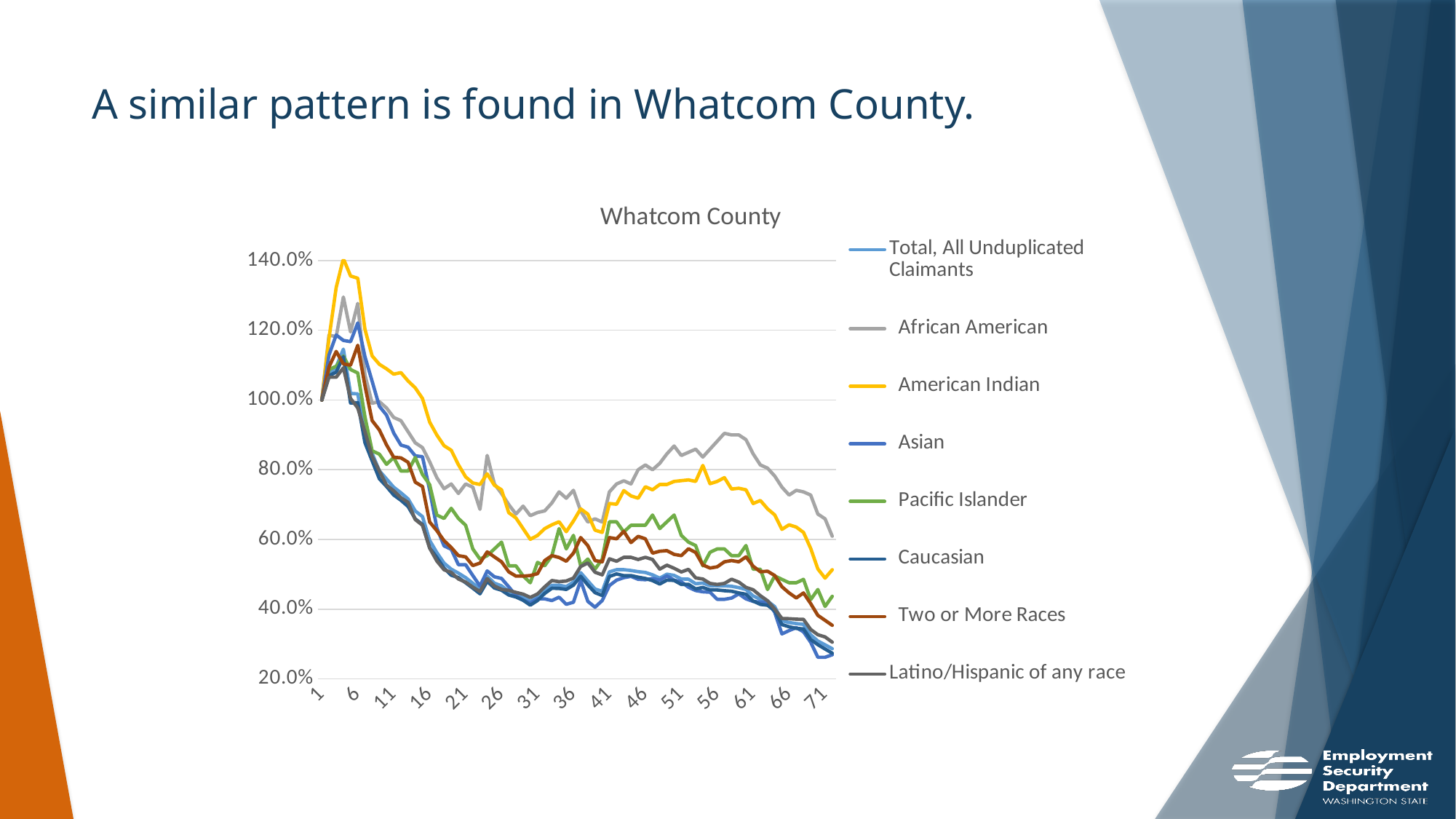
Overall, do the series rise or fall from the left of the x axis to the right? fall What kind of chart is shown on the slide? line chart Which series has the highest value at the right end of the chart (around point 71)? African American Is the value of the Total, All Unduplicated Claimants series at point 71 greater or less than 40.0%? less Which series reaches the highest peak on the chart? American Indian Is the value of the African American series at point 56 greater or less than 80.0%? greater How many series does the legend of the Whatcom County chart list? 8 What value do all the series share at point 1 on the x axis? 100.0% What colour is the American Indian line in the chart? yellow What is the title of the chart? Whatcom County Is the peak value of the American Indian series greater or less than 120.0%? greater At point 56, which is higher: the African American series or the Total, All Unduplicated Claimants series? African American